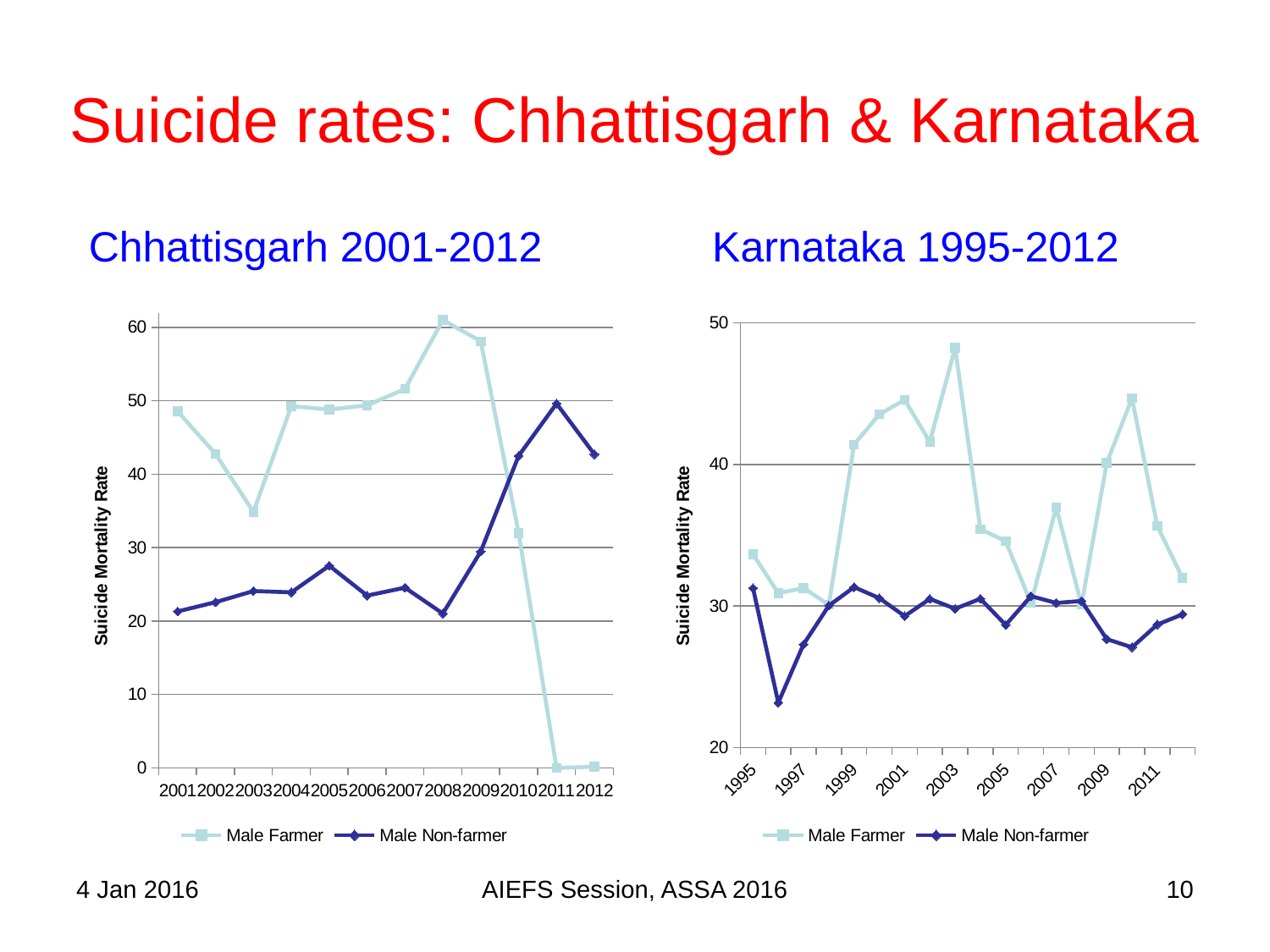
In the Karnataka 1995-2012 chart, which year has the highest Male Farmer value? 2003 In the Chhattisgarh 2001-2012 chart, which year has the highest Male Farmer value? 2008 In the Chhattisgarh 2001-2012 chart, which year has the highest Male Non-farmer value? 2011 How many years are plotted on the x axis of the Chhattisgarh 2001-2012 chart? 12 In the Karnataka 1995-2012 chart, which year has the lowest Male Non-farmer value? 1996 In the Chhattisgarh 2001-2012 chart, is the Male Farmer value for 2008 greater or less than 50? greater In the Chhattisgarh 2001-2012 chart, does the Male Non-farmer series rise or fall from 2008 to 2011? rise What kind of chart is the Chhattisgarh 2001-2012 chart? line chart In the Chhattisgarh 2001-2012 chart, what is the Male Farmer value for 2011? 0 How many series does the legend of the Karnataka 1995-2012 chart list? 2 In the Chhattisgarh 2001-2012 chart, is the Male Non-farmer value for 2001 greater or less than 30? less In the Karnataka 1995-2012 chart, which series has the larger value in 2003, Male Farmer or Male Non-farmer? Male Farmer